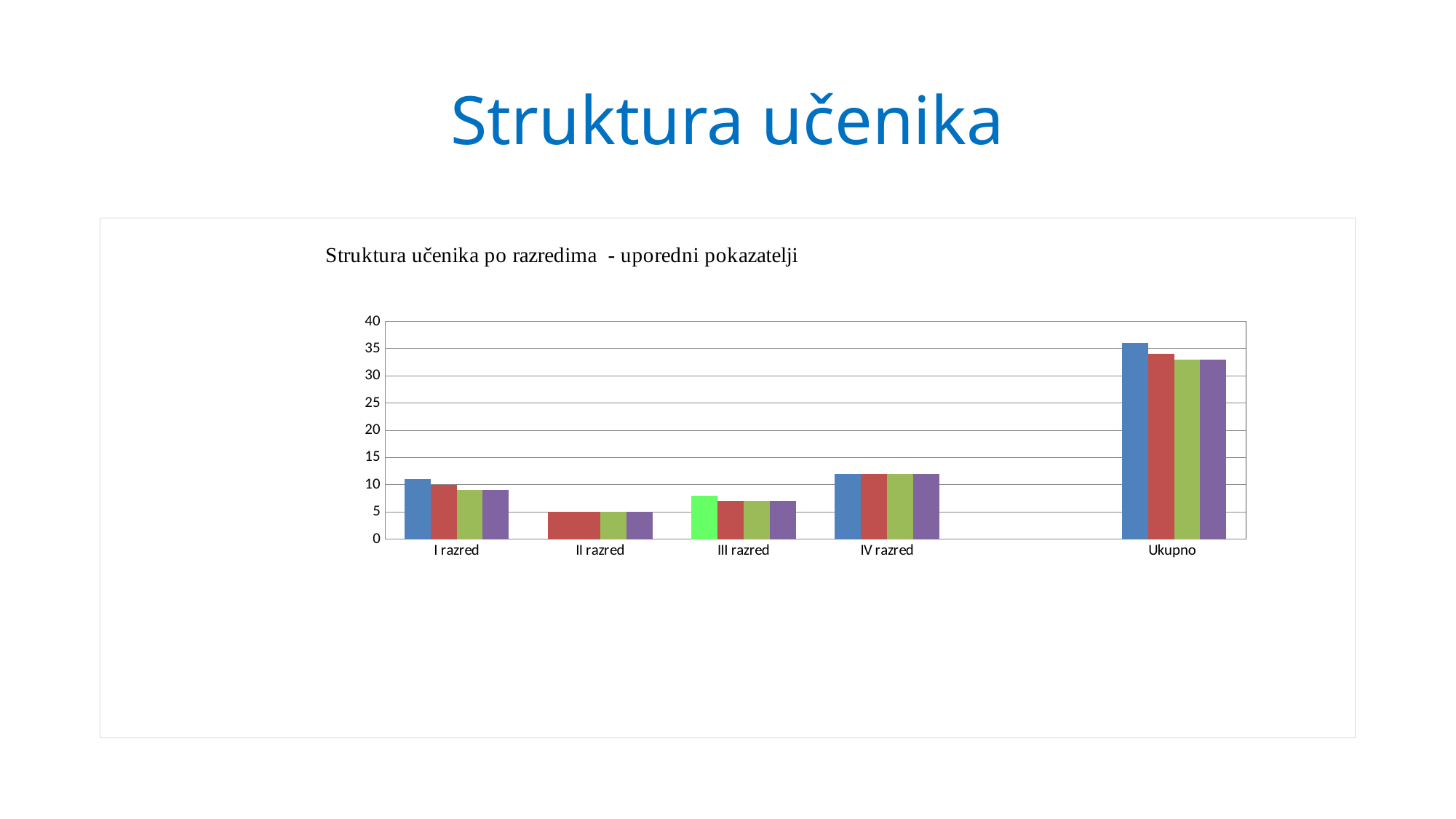
Is the value of the blue bar for I razred greater or less than 10? greater What is the title of the chart? Struktura učenika po razredima - uporedni pokazatelji Which category has the tallest bars in the chart? Ukupno Is the value of the blue bar for Ukupno greater or less than 35? greater What kind of chart is shown on the slide? bar chart Is the value of the red bar for III razred greater or less than 10? less How many bars are plotted for each category in the chart? 4 Which bar is taller for Ukupno, the blue bar or the purple bar? the blue bar Which category has higher bars, IV razred or II razred? IV razred Which category has the shortest bars in the chart? II razred How many categories are shown on the x axis of the chart? 5